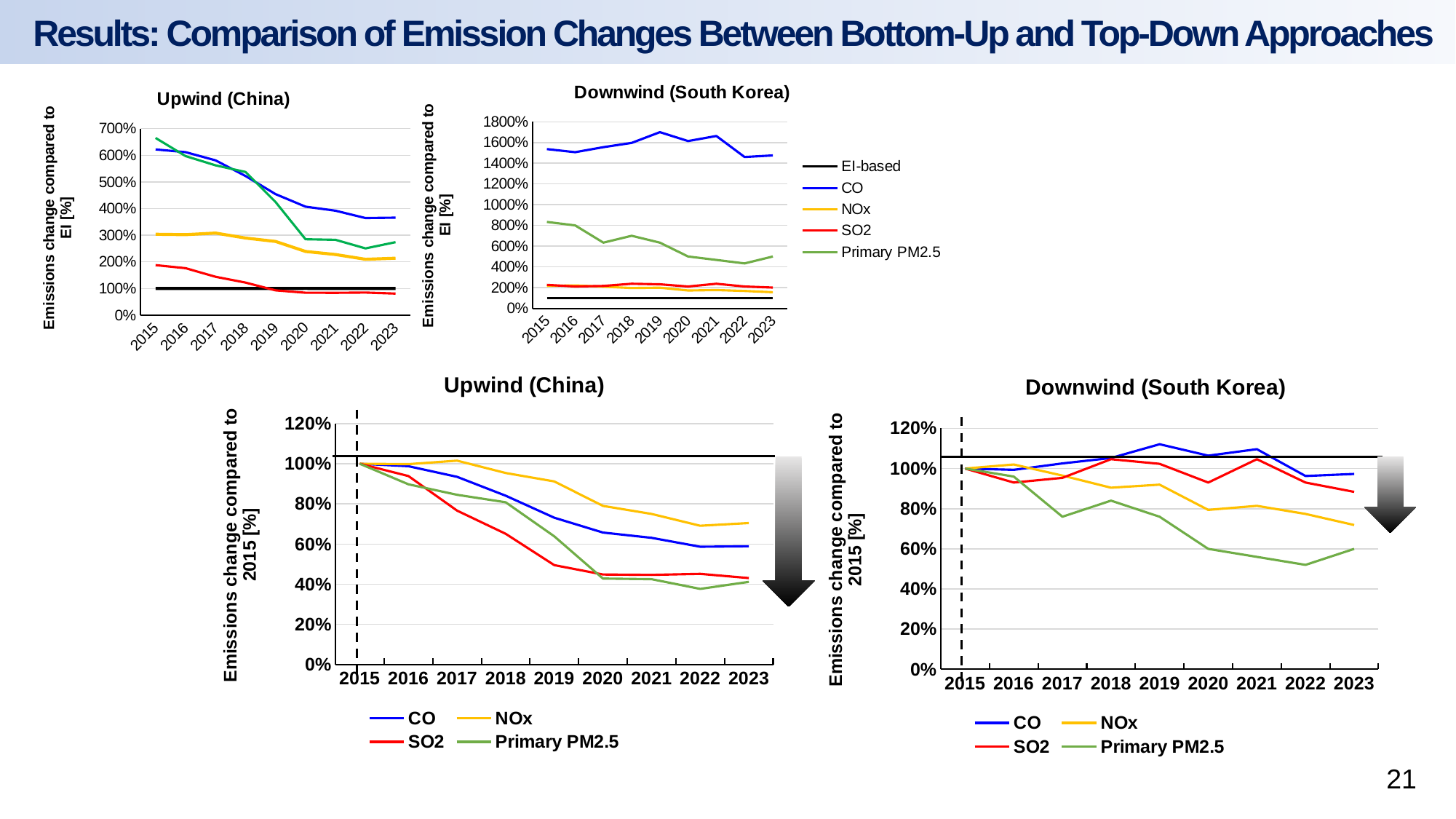
In the bottom-left Upwind (China) chart, is the value for SO2 in 2023 greater or less than 60%? less In the bottom-right Downwind (South Korea) chart, which series has the lowest value in 2022? Primary PM2.5 In the top-right Downwind (South Korea) chart, is the value for CO in 2019 greater or less than 1600%? greater In the top-left Upwind (China) chart, does the CO line rise or fall from 2015 to 2023? fall What kind of chart is the bottom-left chart titled Upwind (China)? line chart In the bottom-left Upwind (China) chart, which series has the highest value in 2023? NOx How many years are plotted on the x axis of the bottom-left Upwind (China) chart? 9 In the bottom-right Downwind (South Korea) chart, which is larger in 2020, NOx or Primary PM2.5? NOx How many series does the legend below the bottom-left Upwind (China) chart list? 4 How many series does the legend next to the top-right Downwind (South Korea) chart list? 5 In the bottom-right Downwind (South Korea) chart, is the value for CO in 2019 greater or less than 100%? greater